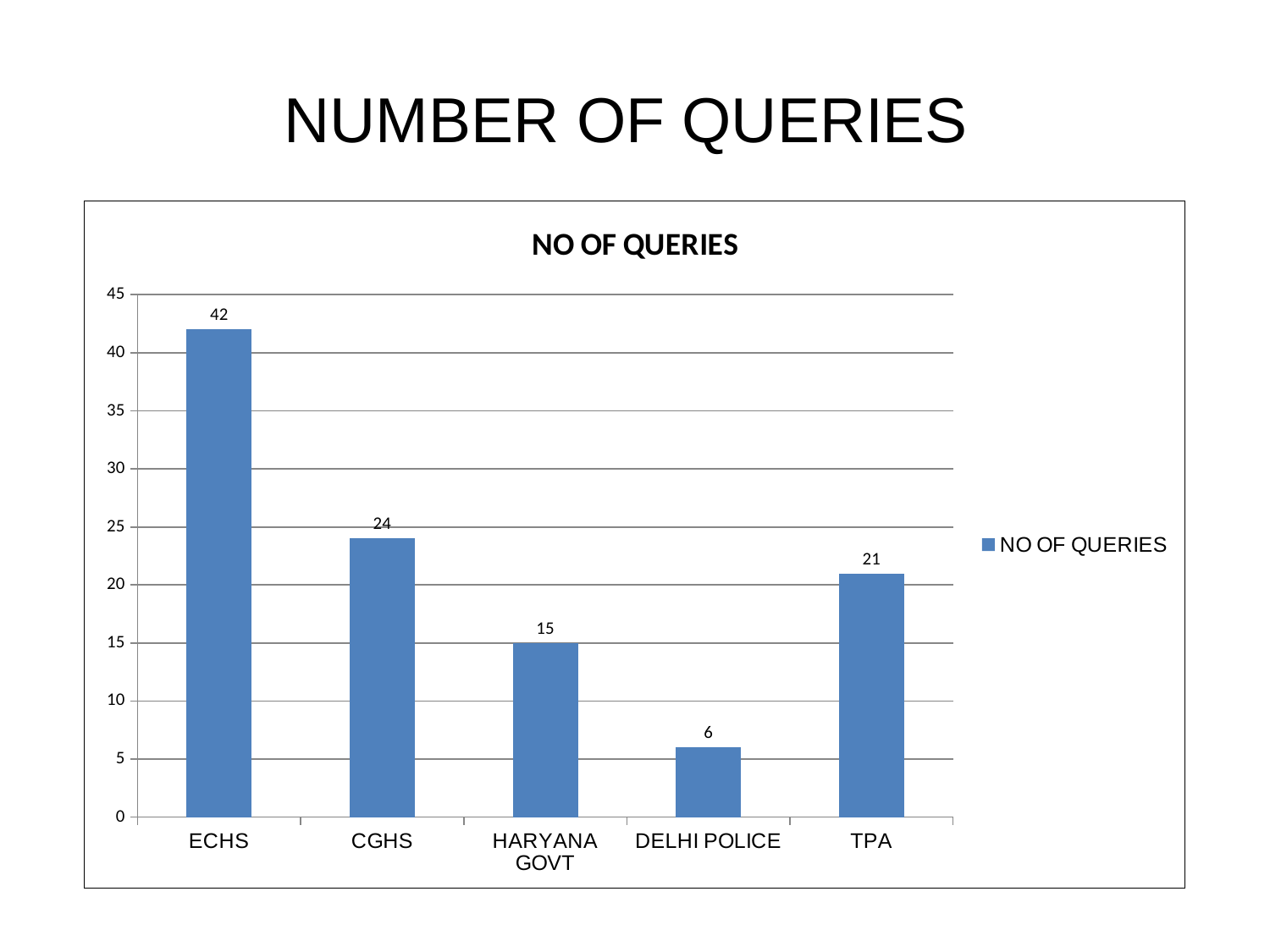
Is the value for HARYANA GOVT greater or less than 20? less What kind of chart is shown on the slide? bar chart What is the number of queries for HARYANA GOVT? 15 Which category has the highest number of queries? ECHS What is the number of queries for ECHS? 42 Which category has the lowest number of queries? DELHI POLICE What is the title of the chart? NO OF QUERIES Which has more queries, CGHS or TPA? CGHS What is the difference between the number of queries for ECHS and CGHS? 18 What is the difference between the number of queries for TPA and DELHI POLICE? 15 How many categories are shown on the x axis? 5 What is the number of queries for TPA? 21